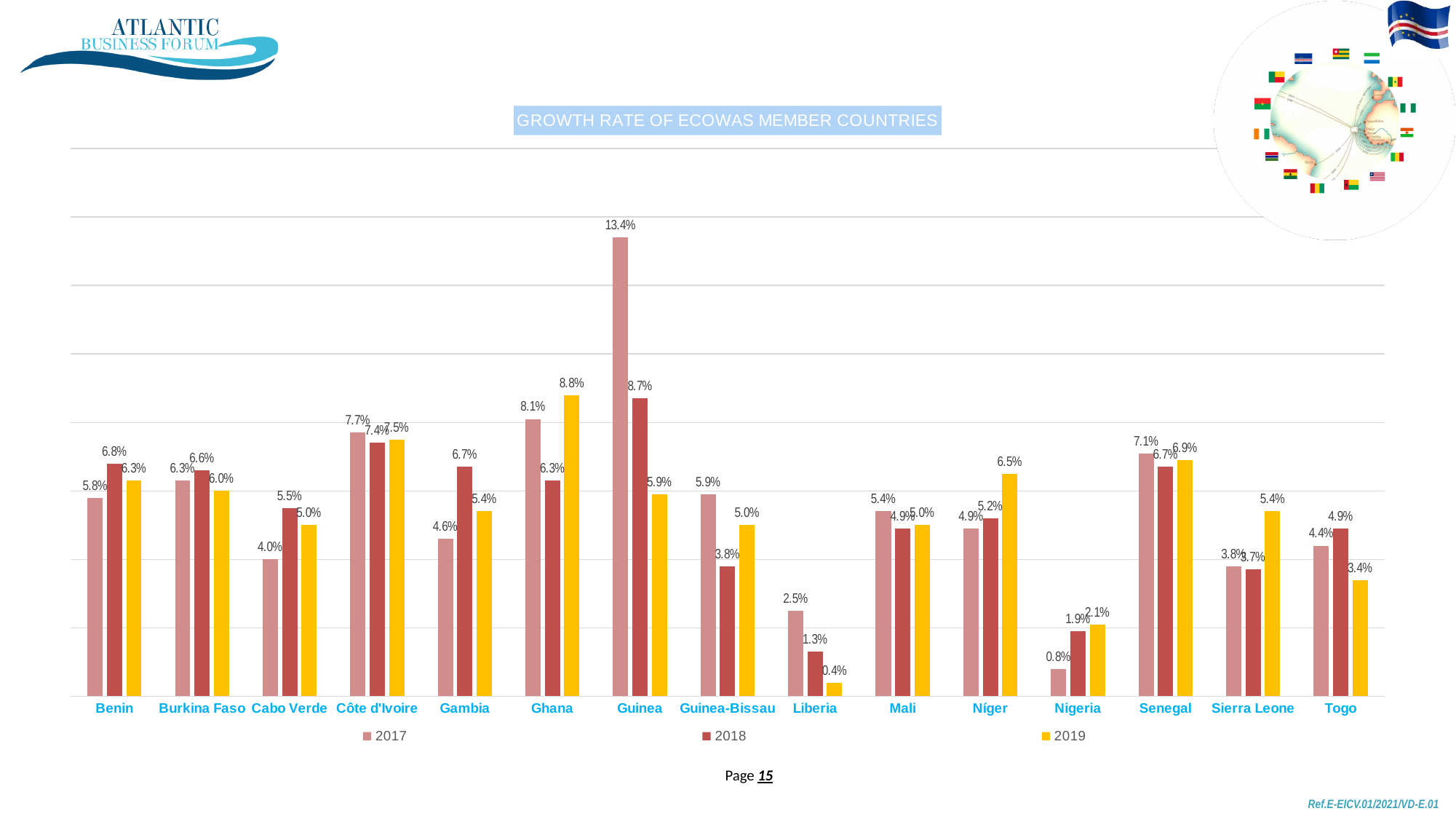
How many series does the legend list? 3 What is the 2017 growth rate for Guinea? 13.4% Which is larger, Senegal's 2019 growth rate or Níger's 2019 growth rate? Senegal's 2019 growth rate What is the 2018 growth rate for Liberia? 1.3% What kind of chart is shown on the slide? Bar chart Which country has the highest 2017 growth rate? Guinea Which country has the lowest 2019 growth rate? Liberia What is the 2019 growth rate for Ghana? 8.8% What is the difference between Guinea's 2017 and 2018 growth rates? 4.7% Which country has the lowest 2017 growth rate? Nigeria Do Liberia's growth rates rise or fall from 2017 to 2019? Fall How many countries are shown on the x axis? 15